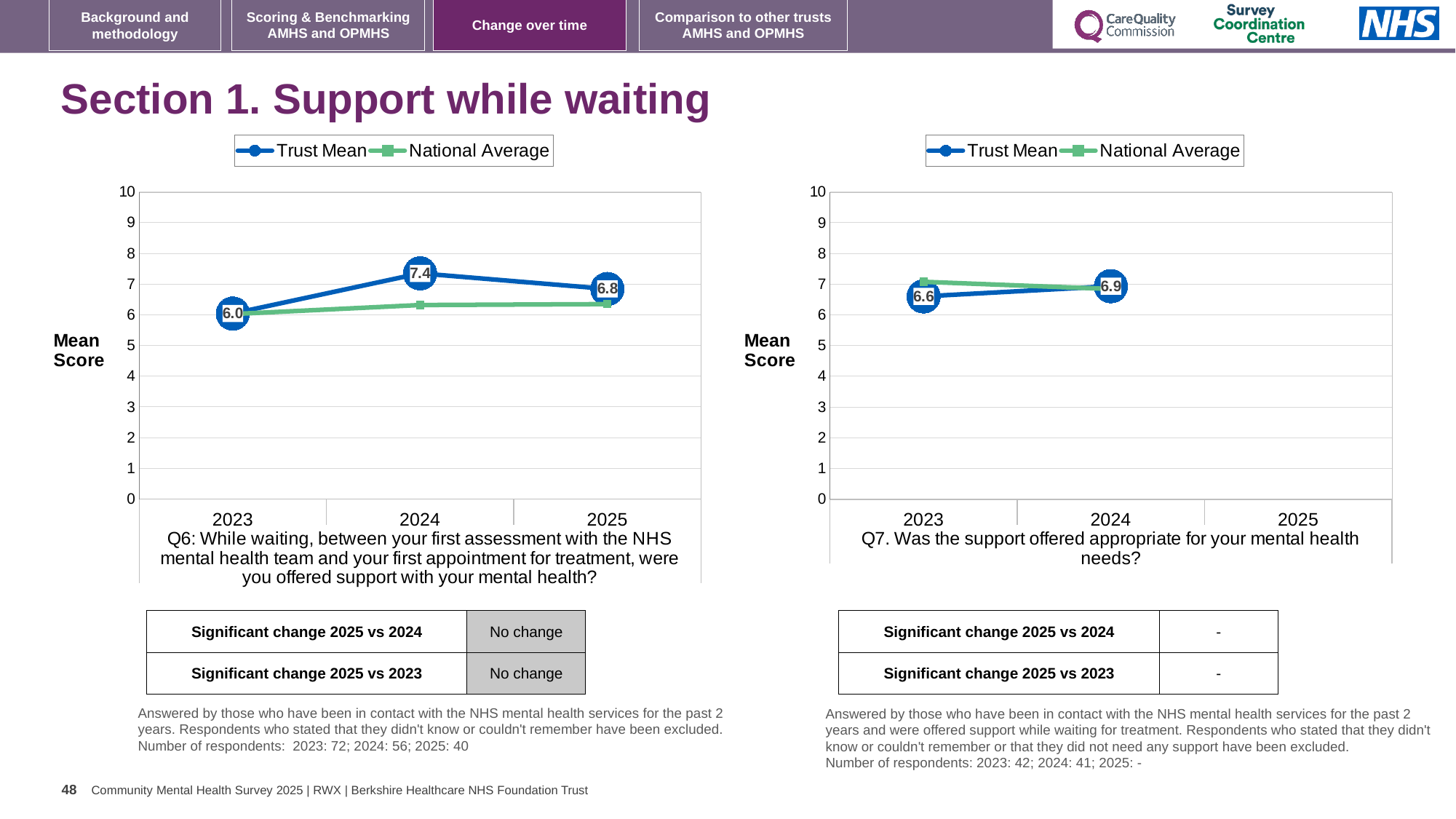
On the Q6 chart (left), what is the Trust Mean score for 2025? 6.8 On the Q6 chart (left), how many series does the legend list? 2 On the Q7 chart (right), is the Trust Mean score for 2024 greater or less than 6? greater What kind of chart is the Q7 chart on the right? Line chart On the Q6 chart (left), what is the difference between the Trust Mean scores for 2024 and 2023? 1.4 On the Q7 chart (right), what is the Trust Mean score for 2024? 6.9 On the Q6 chart (left), which year has the highest Trust Mean score? 2024 On the Q6 chart (left), what is the Trust Mean score for 2024? 7.4 On the Q6 chart (left), what is the Trust Mean score for 2023? 6.0 On the Q6 chart (left), does the Trust Mean rise or fall from 2024 to 2025? Fall On the Q7 chart (right), what is the Trust Mean score for 2023? 6.6 On the Q6 chart (left), which year has the lowest Trust Mean score? 2023